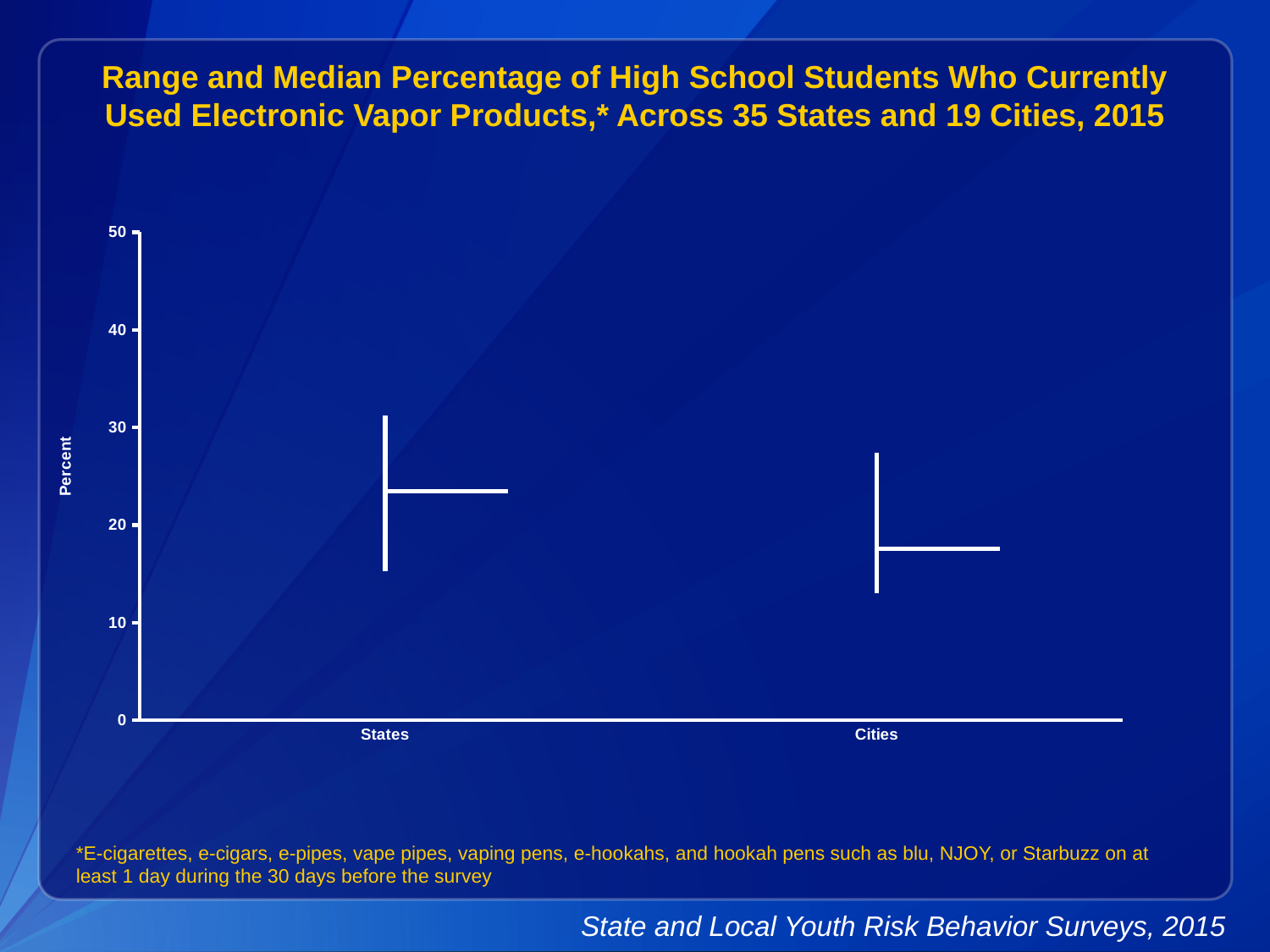
What is the label on the y axis of the chart? Percent How many categories are shown on the x axis of the chart? 2 Is the top of the range for Cities greater or less than 30? less Which category has the higher maximum value in its range, States or Cities? States Is the median value for States greater or less than 20? greater Is the top of the range for States greater or less than 30? greater What are the two categories shown on the x axis? States and Cities Which category has the higher median percentage, States or Cities? States Which category has the lower median percentage? Cities